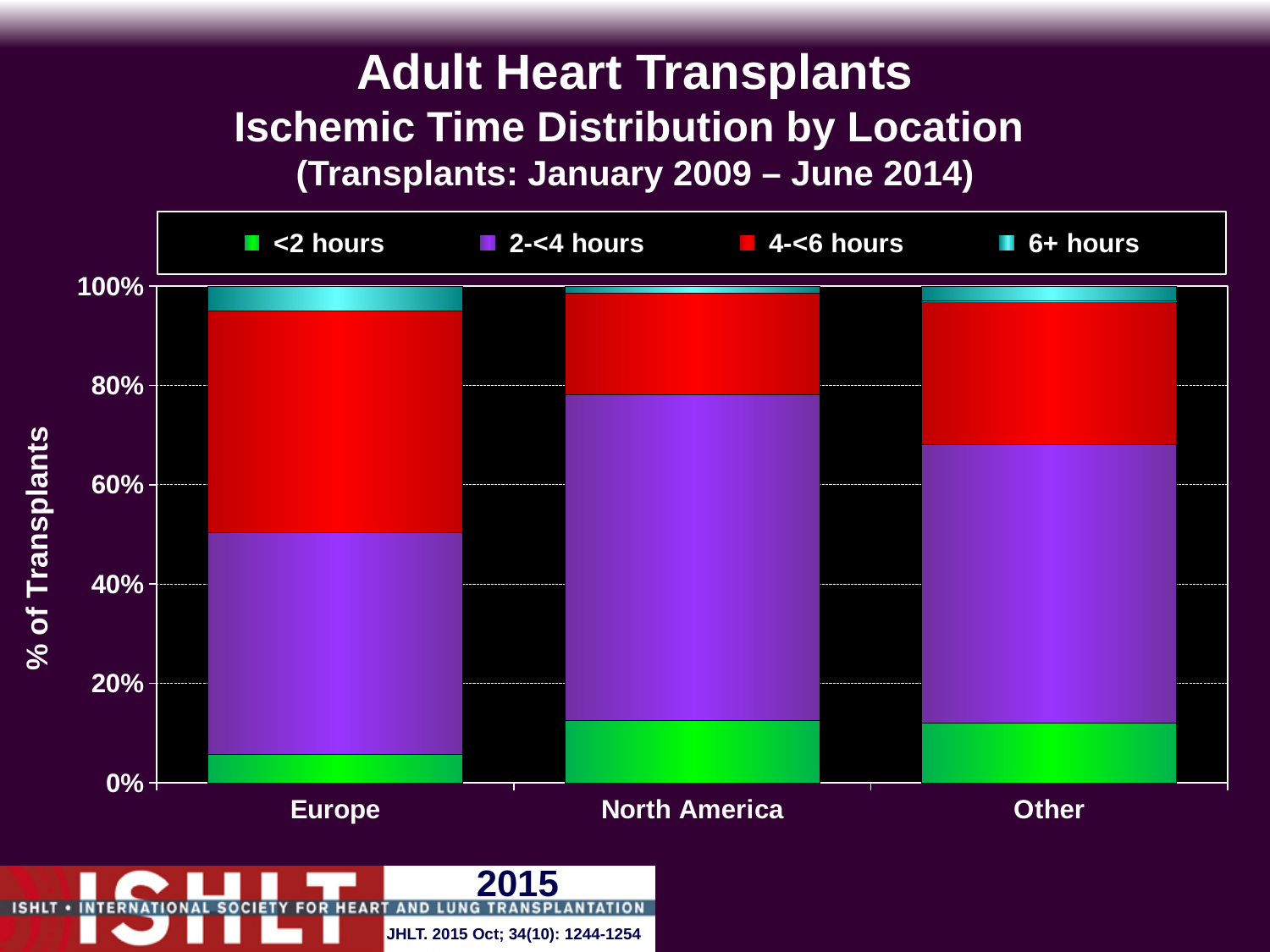
Which location has the largest share of transplants with an ischemic time of 2-<4 hours? North America What is the title of the chart? Adult Heart Transplants Ischemic Time Distribution by Location What is the total height of each stacked bar on the chart? 100% Which colour represents the 4-<6 hours category in the legend? Red How many locations are shown on the x axis of the chart? 3 Which location has the smallest share of transplants with an ischemic time of <2 hours? Europe Which location has the largest share of transplants with an ischemic time of 4-<6 hours? Europe Is the share of 2-<4 hours transplants for North America greater or less than 60%? greater How many series does the legend list? 4 What kind of chart is shown on the slide? Stacked bar chart Is the share of 4-<6 hours transplants larger for Europe or for North America? Europe Is the share of 4-<6 hours transplants for Other greater or less than 40%? less